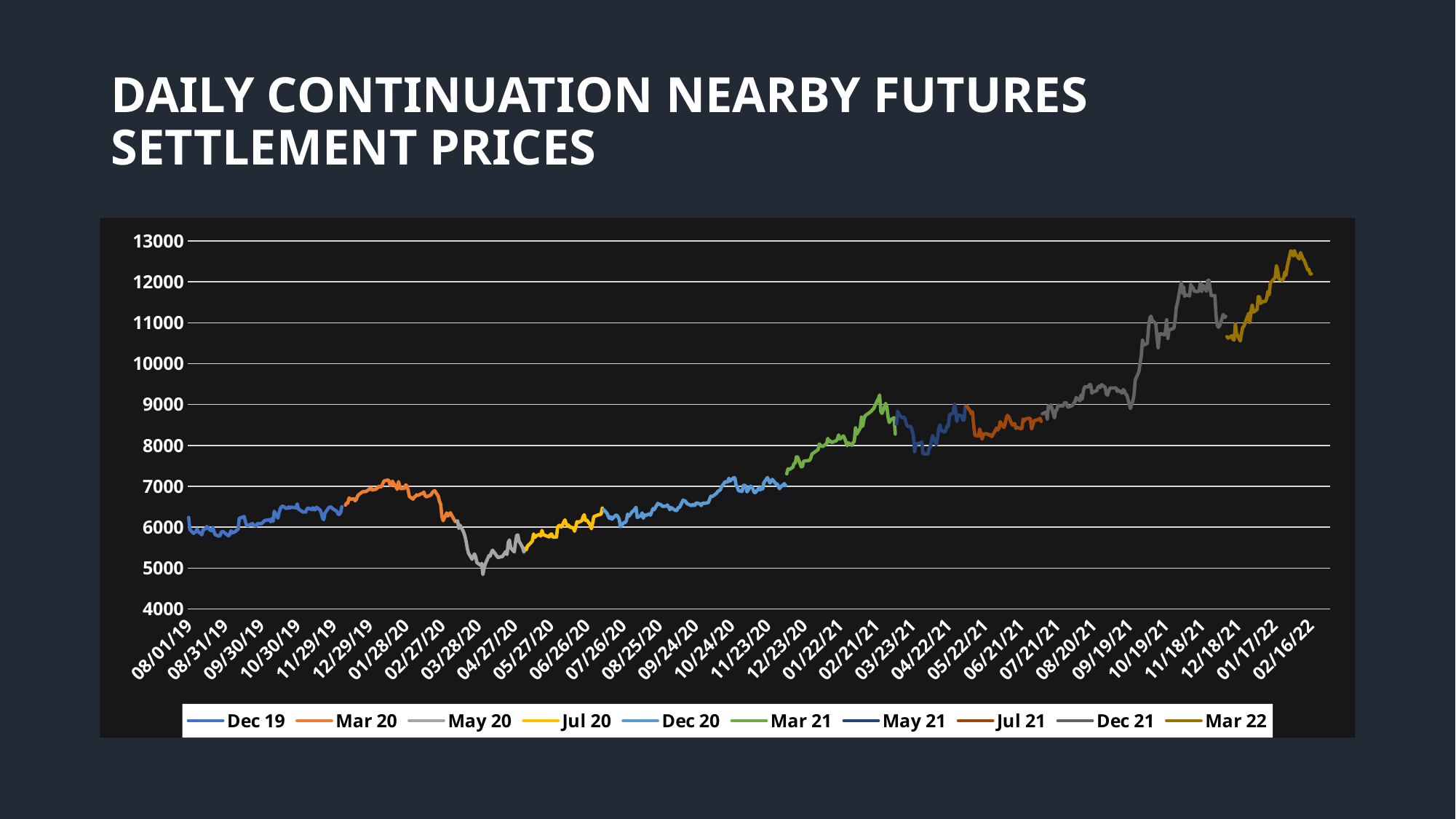
Which series is listed last in the legend? Mar 22 What kind of chart is shown on the slide? line chart Which series reaches the lowest price on the chart? May 20 Which series reaches the highest price on the chart? Mar 22 Which series reaches a higher price, Mar 20 or Dec 21? Dec 21 Is the lowest value of the May 20 series greater or less than 5000? less Overall, do the plotted prices rise or fall from 08/01/19 to 02/16/22? rise What is the title of the chart? Daily Continuation Nearby Futures Settlement Prices Is the peak value of the Mar 21 series greater or less than 9000? greater How many series does the legend list? 10 Is the peak value of the Mar 22 series greater or less than 12000? greater